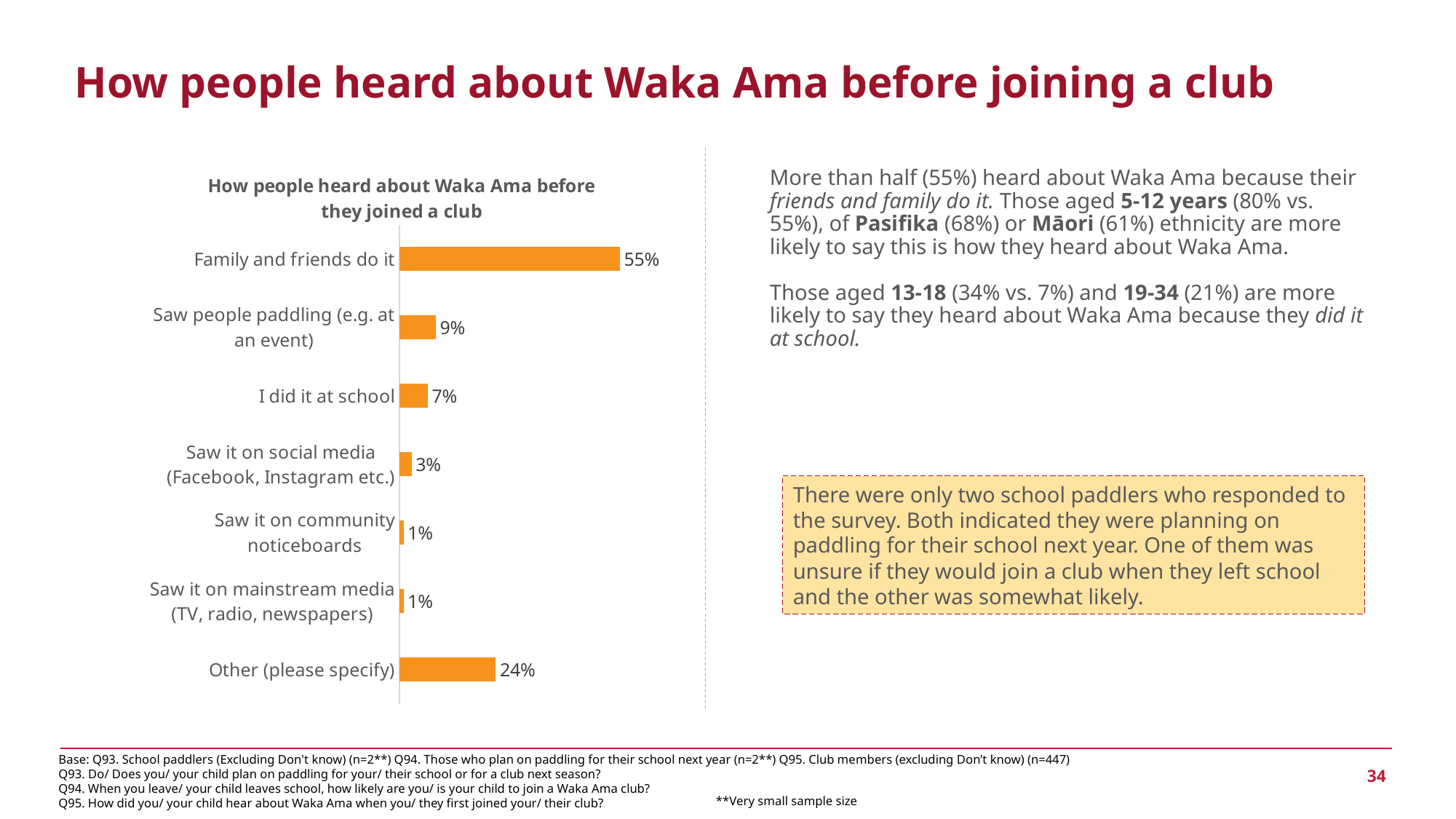
What percentage of people heard about Waka Ama because family and friends do it? 55% What colour are the bars in the chart? Orange What is the title of the chart? How people heard about Waka Ama before they joined a club What is the value for 'Other (please specify)'? 24% What is the value for 'Saw people paddling (e.g. at an event)'? 9% What is the difference between 'Saw it on social media (Facebook, Instagram etc.)' and 'Saw it on community noticeboards'? 2 percentage points How many categories are shown in the chart? 7 What percentage said 'I did it at school'? 7% Which is larger: 'Saw people paddling (e.g. at an event)' or 'I did it at school'? Saw people paddling (e.g. at an event) Which category has the highest value? Family and friends do it What kind of chart is shown on the slide? Bar chart What is the difference between 'Family and friends do it' and 'Other (please specify)'? 31 percentage points